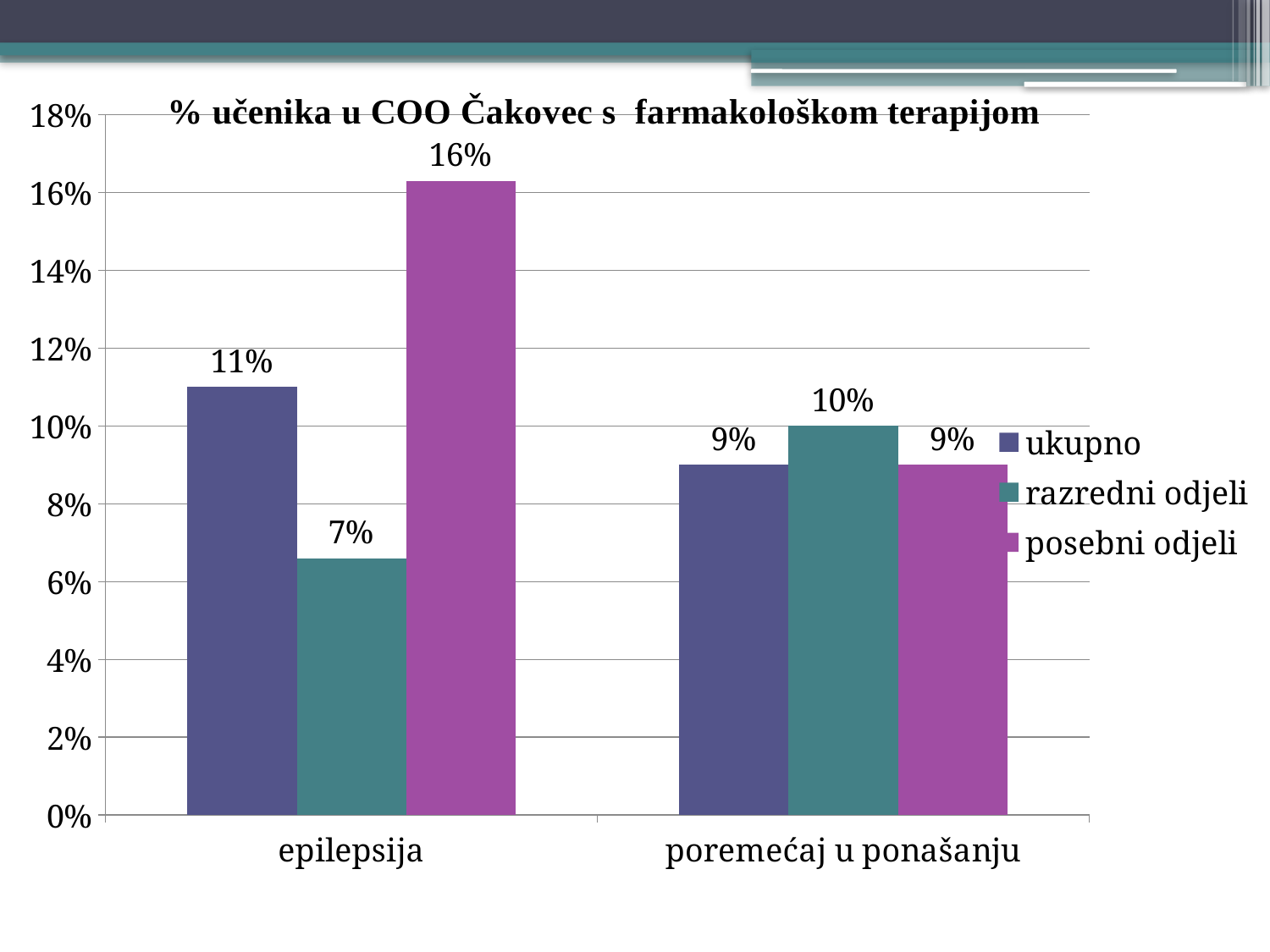
What is the value for 'razredni odjeli' in the 'epilepsija' category? 7% What is the value for 'posebni odjeli' in the 'epilepsija' category? 16% What kind of chart is shown on the slide? bar chart Is the value for 'razredni odjeli' in the 'epilepsija' category greater or less than 8%? less How many series does the legend list? 3 What is the value for 'razredni odjeli' in the 'poremećaj u ponašanju' category? 10% What is the value for 'ukupno' in the 'poremećaj u ponašanju' category? 9% Which series has the lowest value in the 'epilepsija' category? razredni odjeli How many categories are shown on the x axis? 2 Which series has the highest value in the 'epilepsija' category? posebni odjeli Which is larger: 'ukupno' for 'epilepsija' or 'ukupno' for 'poremećaj u ponašanju'? ukupno for epilepsija